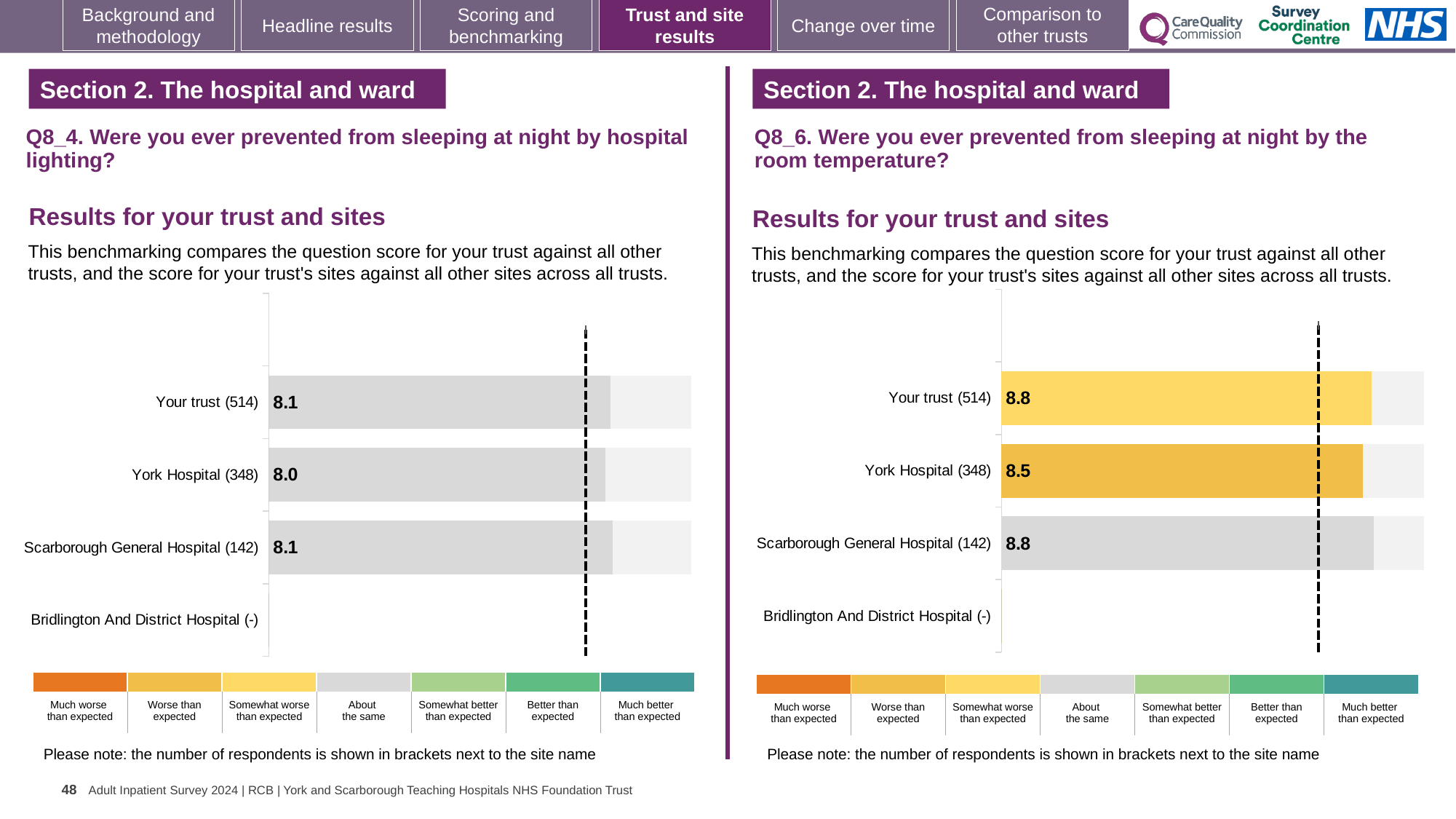
In the Q8_4 hospital lighting chart, what is the score for Your trust (514)? 8.1 In the Q8_6 room temperature chart, what is the score for York Hospital (348)? 8.5 What type of chart is used in the Q8_6 room temperature chart? Bar chart In the Q8_4 hospital lighting chart, what is the score for York Hospital (348)? 8.0 In the Q8_6 room temperature chart, what is the score for Scarborough General Hospital (142)? 8.8 How many sites or rows are listed in the Q8_4 hospital lighting chart? 4 In the Q8_4 hospital lighting chart, what is the difference between the scores for Scarborough General Hospital and York Hospital? 0.1 In the Q8_6 room temperature chart, what is the difference between the scores for Your trust and York Hospital? 0.3 In the Q8_6 room temperature chart, which site has no score shown? Bridlington And District Hospital (-) In the Q8_6 room temperature chart, which site has the lowest score? York Hospital (348) In the Q8_6 room temperature chart, which has the higher score, Your trust or York Hospital? Your trust In the Q8_4 hospital lighting chart, which site has the lowest score? York Hospital (348)